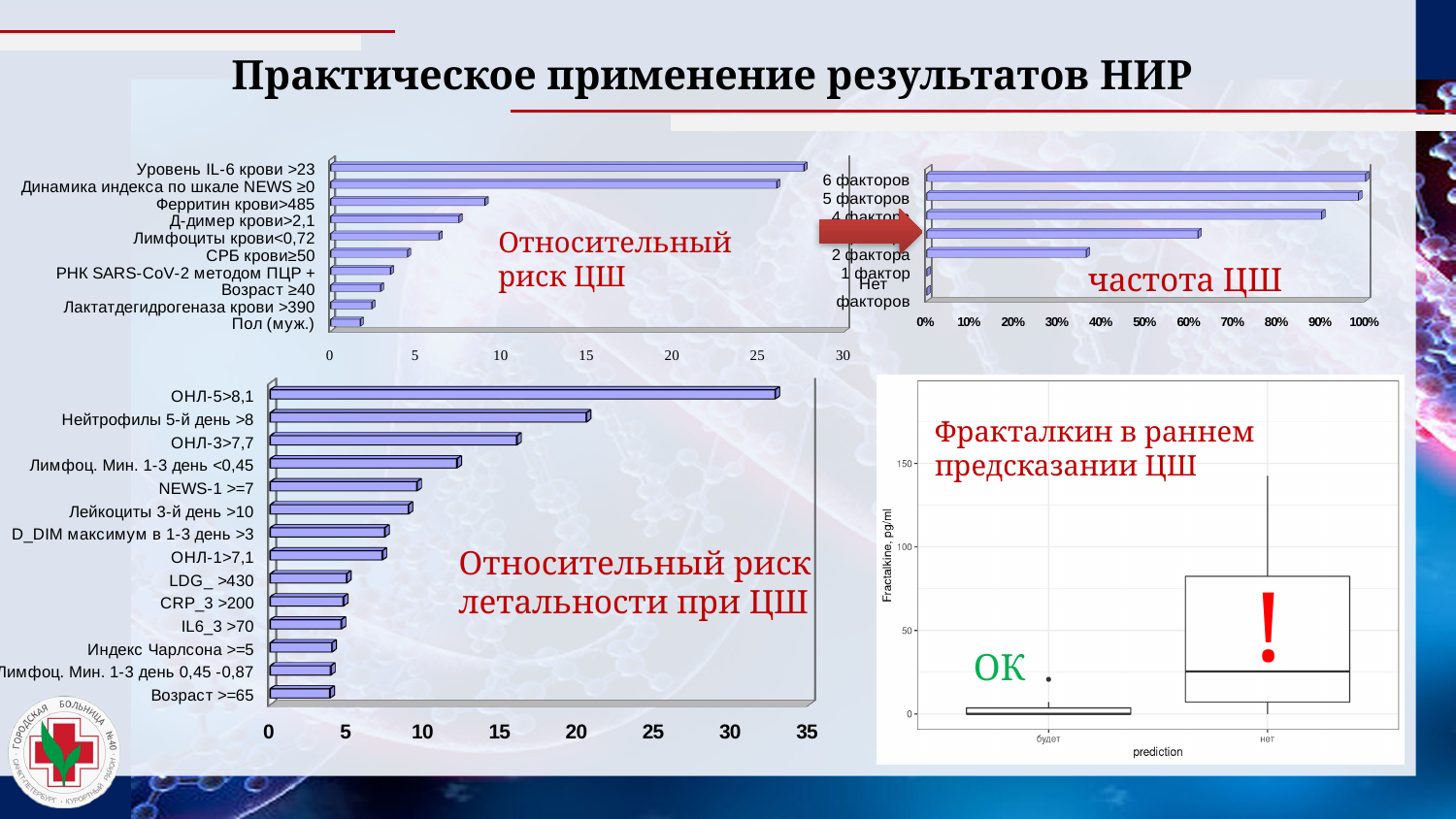
In the chart titled "Относительный риск ЦШ" (top left), is the value for "Ферритин крови>485" greater or less than 15? less In the chart titled "Относительный риск ЦШ" (top left), which category has the lowest value? Пол (муж.) In the chart titled "частота ЦШ" (top right), is the value for "2 фактора" greater or less than 50%? less In the chart titled "Относительный риск ЦШ" (top left), is the value for "Уровень IL-6 крови >23" greater or less than 25? greater In the chart titled "Относительный риск летальности при ЦШ" (bottom left), which category has the highest value? ОНЛ-5>8,1 In the chart titled "Относительный риск летальности при ЦШ" (bottom left), which is larger: "Нейтрофилы 5-й день >8" or "ОНЛ-3>7,7"? Нейтрофилы 5-й день >8 In the chart titled "Относительный риск ЦШ" (top left), which category has the highest value? Уровень IL-6 крови >23 How many categories are plotted in the chart titled "Относительный риск ЦШ" (top left)? 10 In the chart titled "частота ЦШ" (top right), which category has the highest value? 6 факторов What kind of chart is the one titled "Фракталкин в раннем предсказании ЦШ" (bottom right)? box plot